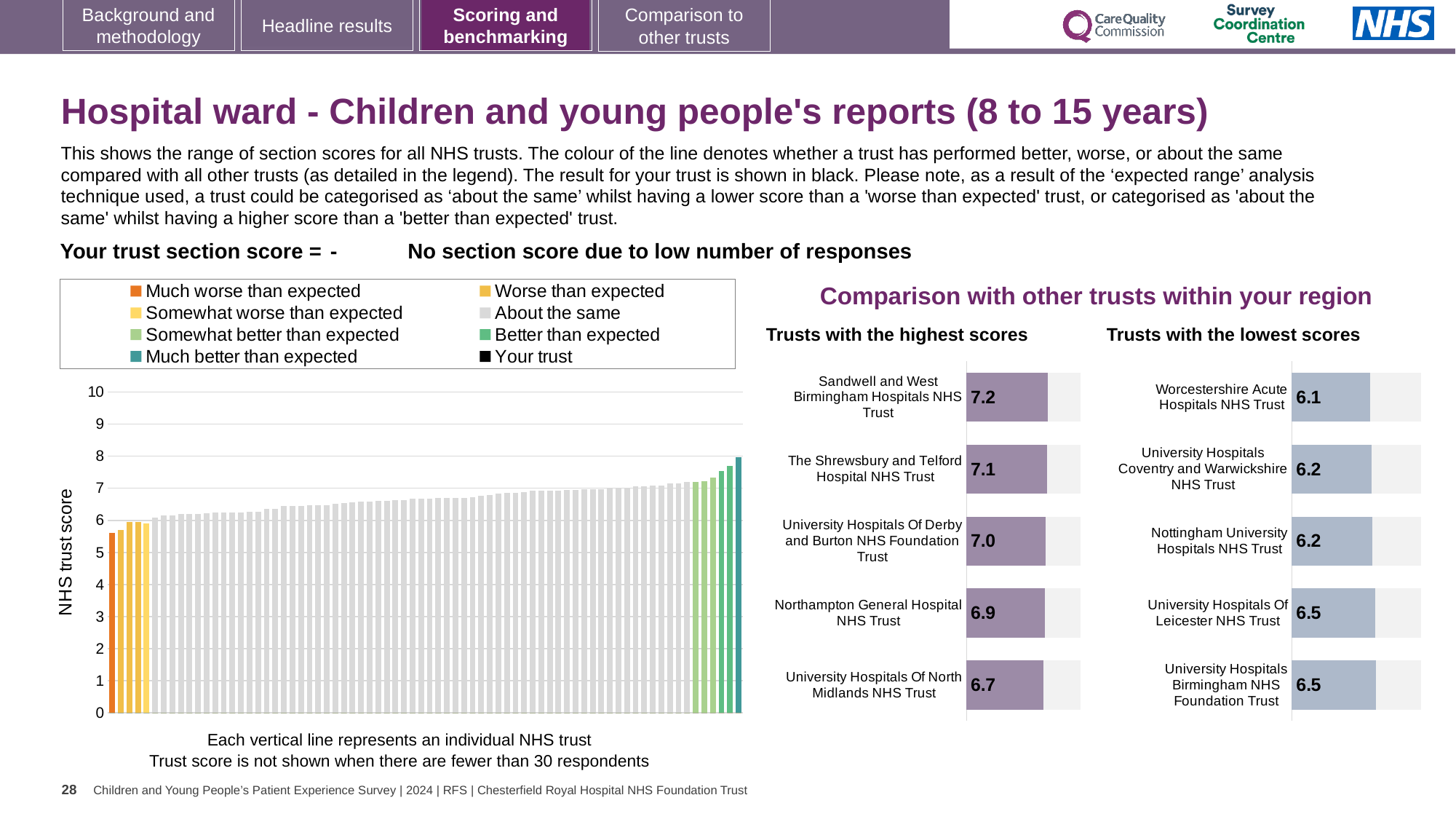
In the 'Trusts with the highest scores' chart, what is the score for Northampton General Hospital NHS Trust? 6.9 In the large 'NHS trust score' chart on the left, is the value of the leftmost (orange) bar greater or less than 6? less In the 'Trusts with the lowest scores' chart, which trust has the lowest score? Worcestershire Acute Hospitals NHS Trust In the 'Trusts with the highest scores' chart, which trust has the lowest score shown? University Hospitals Of North Midlands NHS Trust How many entries does the legend above the large 'NHS trust score' chart list? 8 In the 'Trusts with the highest scores' chart, what is the difference between the scores of Sandwell and West Birmingham Hospitals NHS Trust and University Hospitals Of North Midlands NHS Trust? 0.5 In the 'Trusts with the lowest scores' chart, what is the score for University Hospitals Of Leicester NHS Trust? 6.5 How many trusts are listed in the 'Trusts with the highest scores' chart? 5 Which is higher: the score for The Shrewsbury and Telford Hospital NHS Trust in the highest-scores chart, or the score for Nottingham University Hospitals NHS Trust in the lowest-scores chart? The Shrewsbury and Telford Hospital NHS Trust In the 'Trusts with the lowest scores' chart, what is the score for Worcestershire Acute Hospitals NHS Trust? 6.1 In the large 'NHS trust score' chart on the left, do the bar values rise or fall from left to right? rise In the 'Trusts with the highest scores' chart, what is the score for Sandwell and West Birmingham Hospitals NHS Trust? 7.2